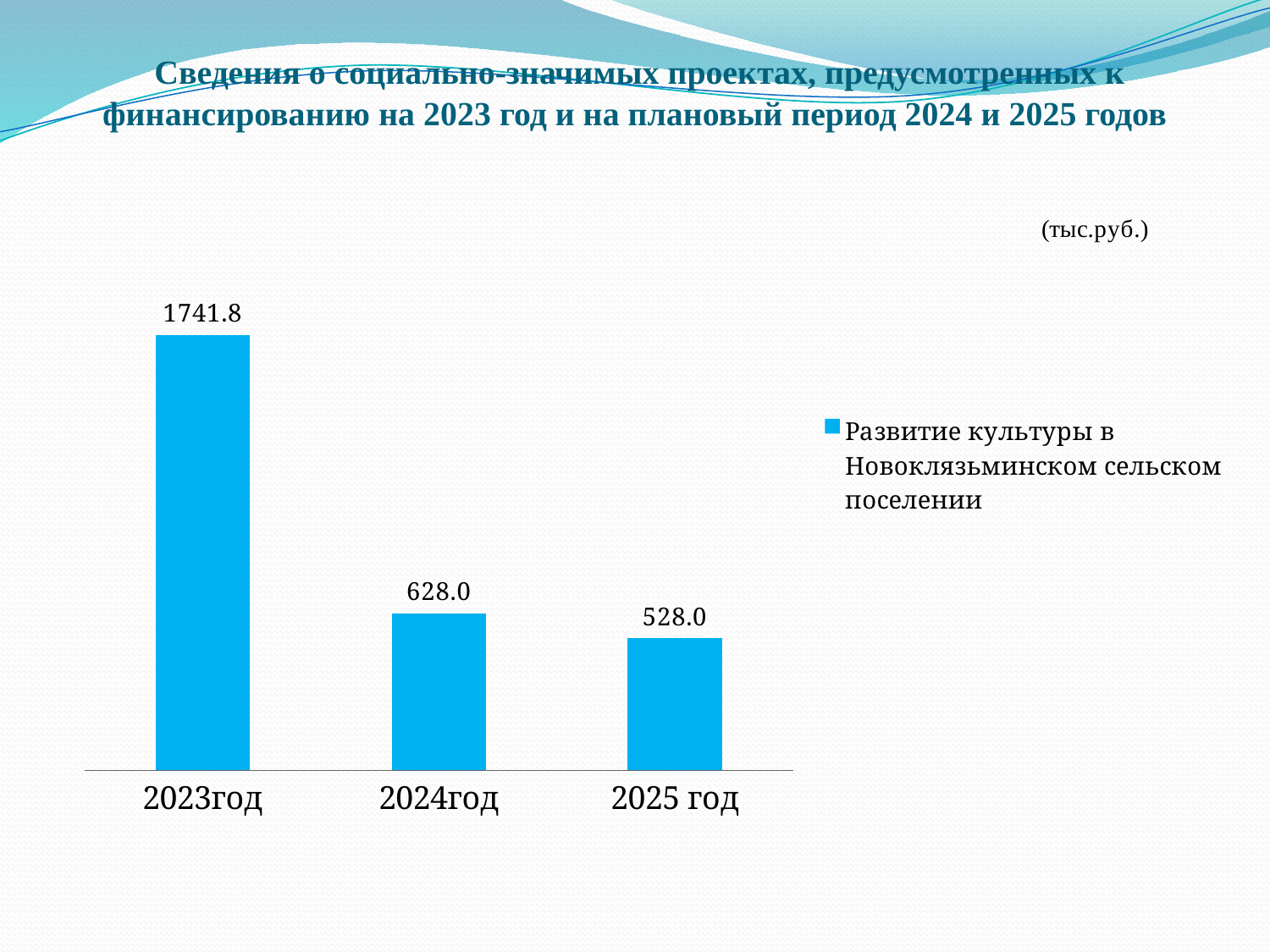
Which is larger, the value for 2024год or the value for 2025 год? 2024год What kind of chart is shown on the slide? bar chart What is the value for 2025 год? 528.0 Do the values rise or fall from 2023год to 2025 год? fall How many years are shown on the chart? 3 What is the value for 2024год? 628.0 What is the difference between the values for 2023год and 2024год? 1113.8 Which year has the highest value? 2023год Which year has the lowest value? 2025 год What is the difference between the values for 2024год and 2025 год? 100.0 How many series does the legend list? 1 What is the value for 2023год? 1741.8